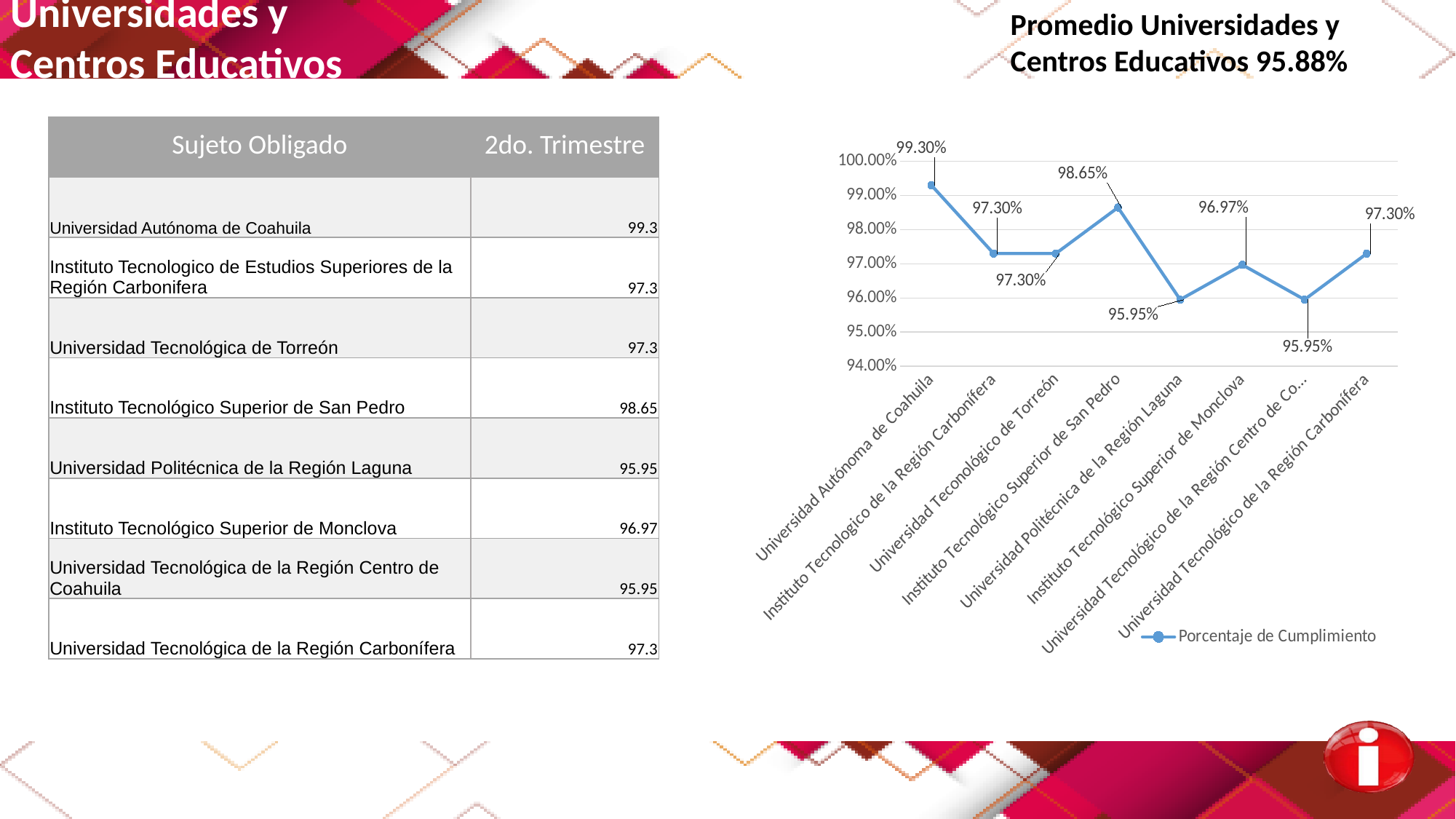
What is the value plotted for Instituto Tecnológico Superior de San Pedro? 98.65% What is the lowest value plotted in the chart? 95.95% What type of chart is shown on the slide? Line chart Which category has the highest value in the chart? Universidad Autónoma de Coahuila What is the difference between the values for Universidad Autónoma de Coahuila and Instituto Tecnológico Superior de San Pedro? 0.65% What is the value plotted for Instituto Tecnológico Superior de Monclova? 96.97% How many series does the chart legend list? 1 What is the name of the series shown in the chart legend? Porcentaje de Cumplimiento Which is larger, the value for Instituto Tecnológico Superior de Monclova or the value for Universidad Politécnica de la Región Laguna? Instituto Tecnológico Superior de Monclova How many data points are plotted on the line chart? 8 What is the value plotted for Universidad Autónoma de Coahuila? 99.30% What is the value plotted for Universidad Politécnica de la Región Laguna? 95.95%